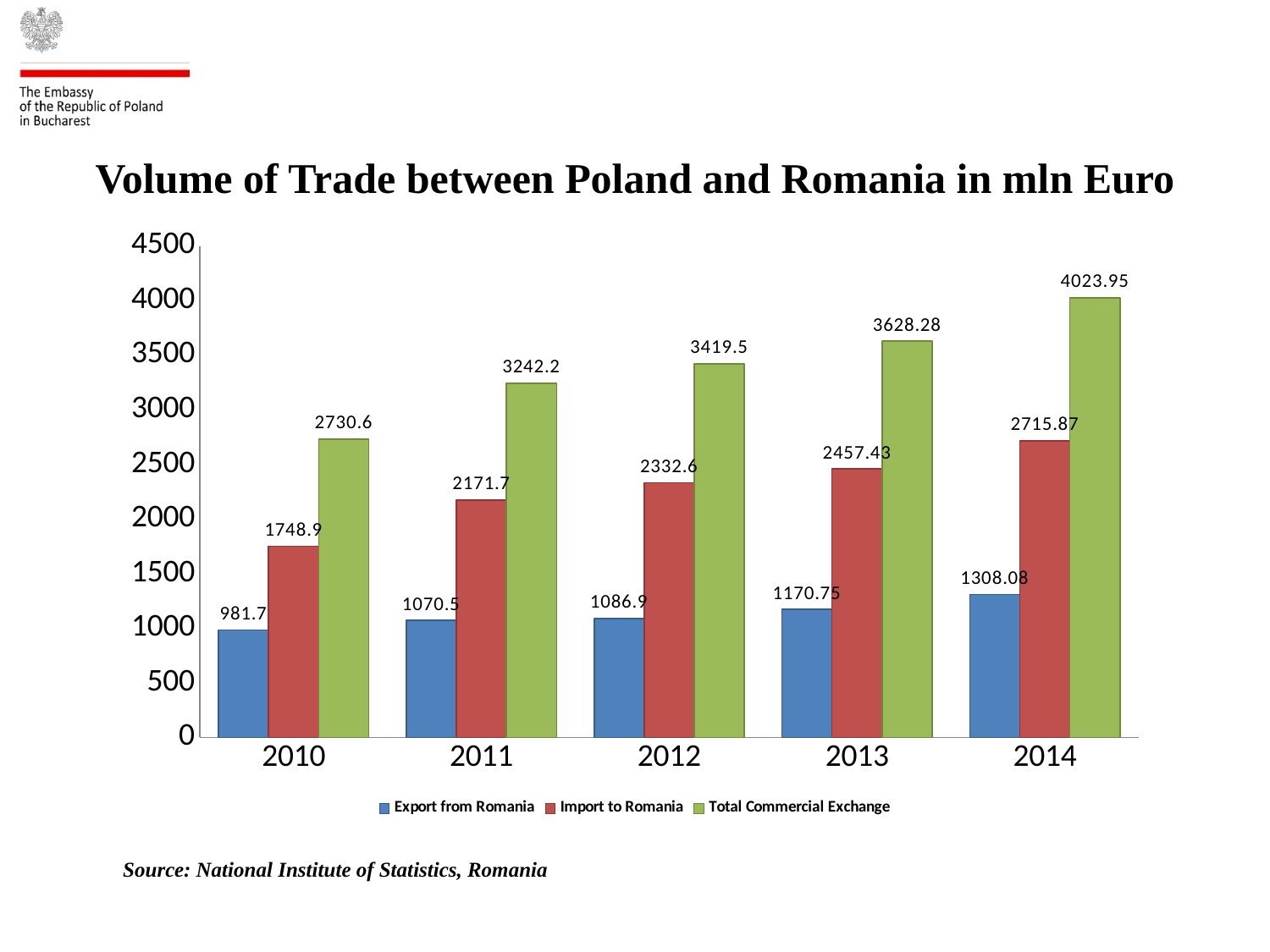
How many years are shown on the x axis? 5 In which year is Export from Romania lowest? 2010 What kind of chart is shown on the slide? bar chart Does the Total Commercial Exchange rise or fall from 2010 to 2014? rise What is the difference between Import to Romania and Export from Romania in 2012? 1245.7 Which is larger in 2011: Import to Romania or Export from Romania? Import to Romania How many series does the legend list? 3 Is the Total Commercial Exchange in 2013 greater or less than 3500? greater What is the Total Commercial Exchange in 2014? 4023.95 In which year is the Total Commercial Exchange highest? 2014 What is the value of Export from Romania in 2010? 981.7 What is the value of Import to Romania in 2013? 2457.43